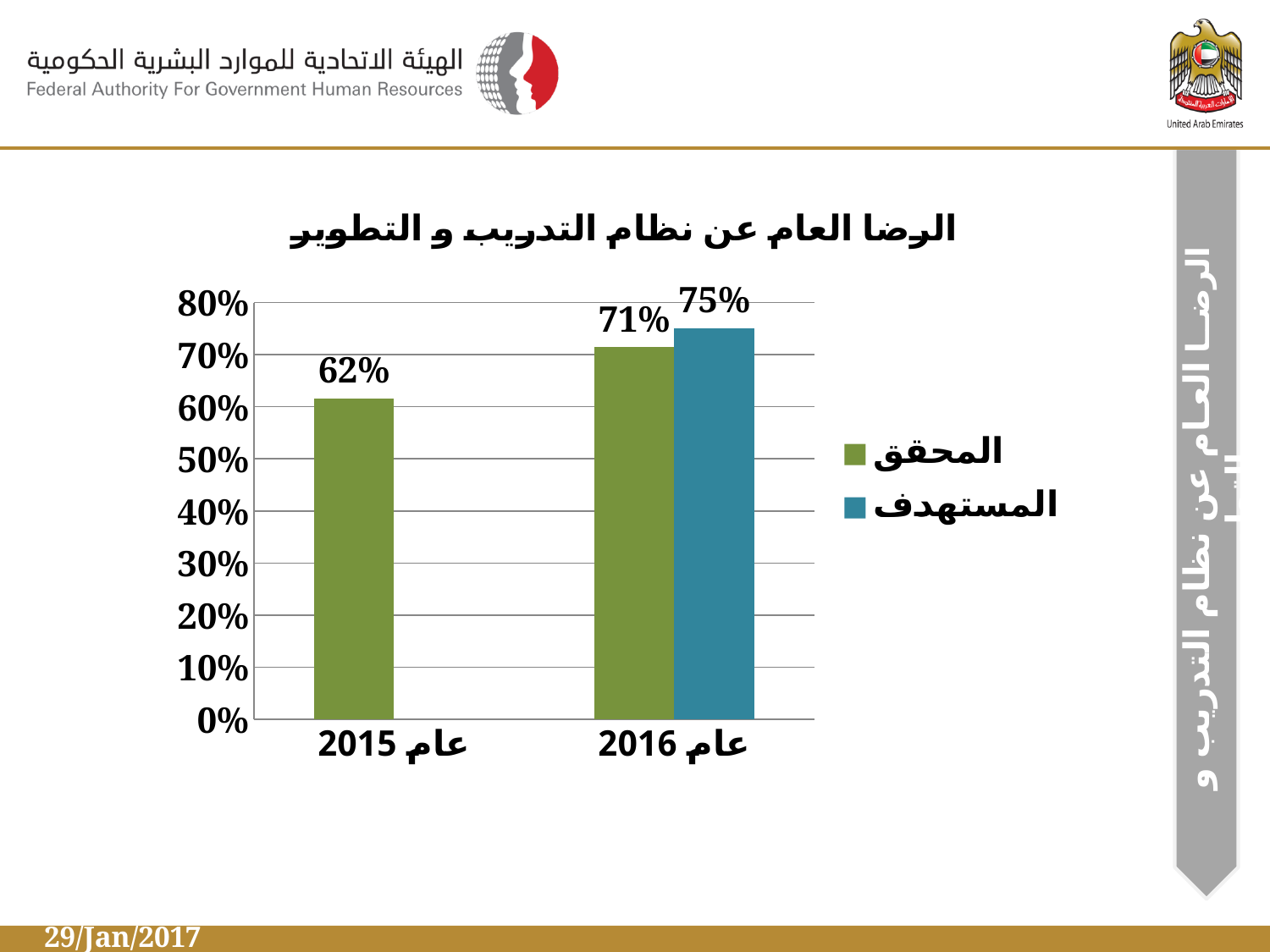
Which year has the higher المحقق (achieved) value? عام 2016 For عام 2016, which is larger: المحقق (achieved) or المستهدف (target)? المستهدف What is the value of المستهدف (target) for عام 2016? 75% What is the value of المحقق (achieved) for عام 2016? 71% How many year categories are shown on the x axis? 2 How many series does the legend list? 2 What is the difference between المستهدف (target) and المحقق (achieved) for عام 2016? 4% What is the difference between the المحقق (achieved) values for عام 2016 and عام 2015? 9% What is the value of المحقق (achieved) for عام 2015? 62% Does the المحقق (achieved) value rise or fall from عام 2015 to عام 2016? rise Is the المحقق (achieved) value for عام 2015 greater or less than 70%? less What kind of chart is shown on the slide? bar chart